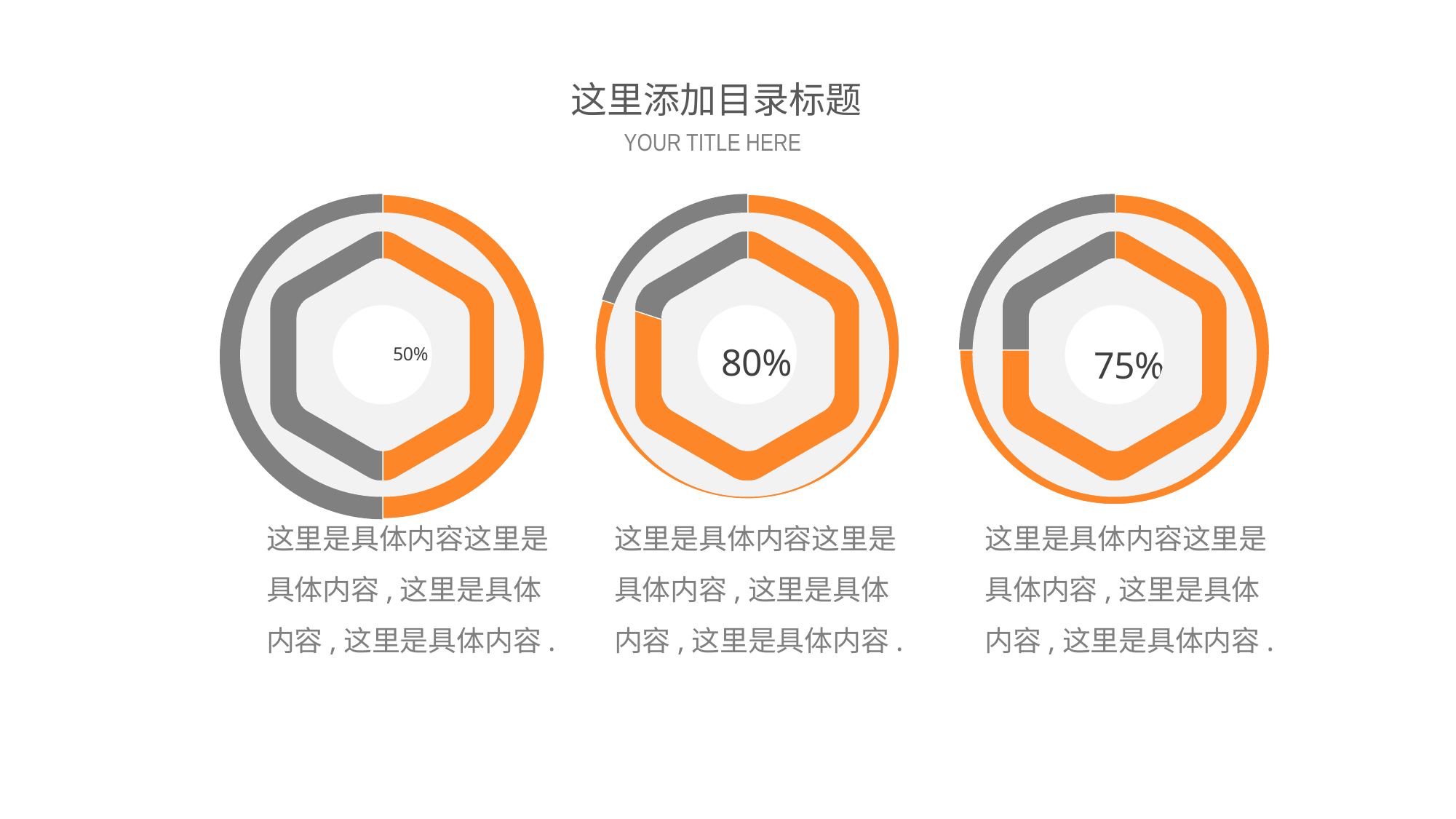
What is the difference between the percentage in the middle chart and the percentage in the right chart? 5% What percentage is shown in the centre of the left chart? 50% Which of the three charts shows the highest percentage? The middle chart (80%) What percentage is shown in the centre of the middle chart? 80% What colour is used for the unfilled (remaining) portion of each ring chart? Grey How many ring charts are shown on the slide? 3 What kind of chart is used to display each percentage on the slide? Doughnut (ring) chart Which is larger, the percentage in the right chart or the percentage in the left chart? The right chart (75%) What is the difference between the percentage in the middle chart and the percentage in the left chart? 30% What colour is used for the filled (completed) portion of each ring chart? Orange What percentage is shown in the centre of the right chart? 75% Which of the three charts shows the lowest percentage? The left chart (50%)